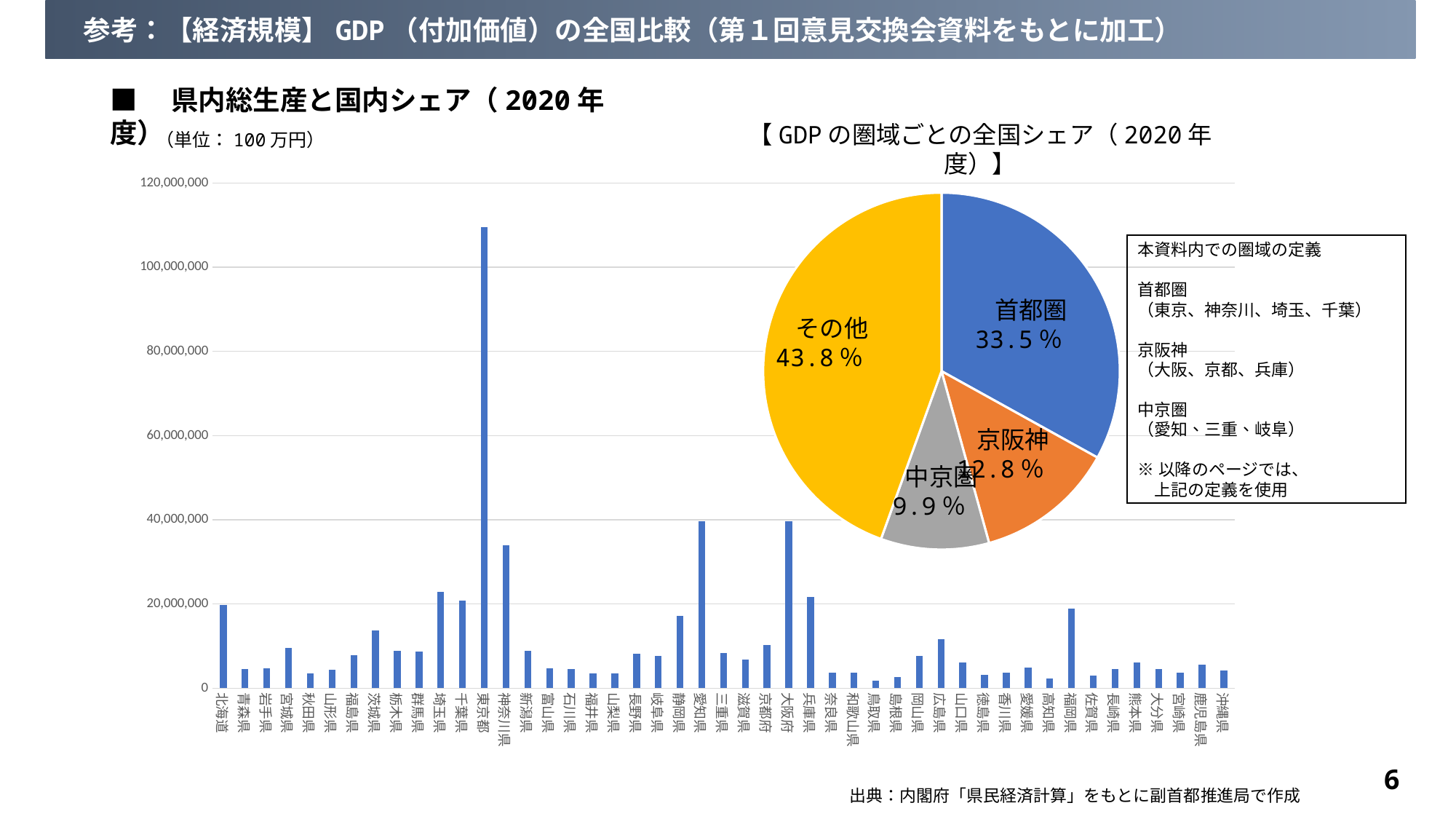
In the bar chart on the left, is the value for 東京都 greater or less than 100,000,000? greater In the pie chart on the right, what is the share for 中京圏? 9.9% In the pie chart on the right, how many slices are there? 4 In the bar chart on the left (県内総生産と国内シェア), which prefecture has the highest value? 東京都 In the pie chart on the right, how many percentage points larger is 首都圏 than 京阪神? 20.7 In the pie chart on the right, which slice has the smallest share? 中京圏 In the pie chart on the right, what is the share for 京阪神? 12.8% What kind of chart is the chart on the right of the slide? Pie chart In the bar chart on the left, is the value for 神奈川県 greater or less than 40,000,000? less In the pie chart on the right (GDPの圏域ごとの全国シェア), what is the share for 首都圏? 33.5% In the pie chart on the right, which slice has the largest share? その他 In the bar chart on the left, which is larger, the value for 東京都 or the value for 大阪府? 東京都